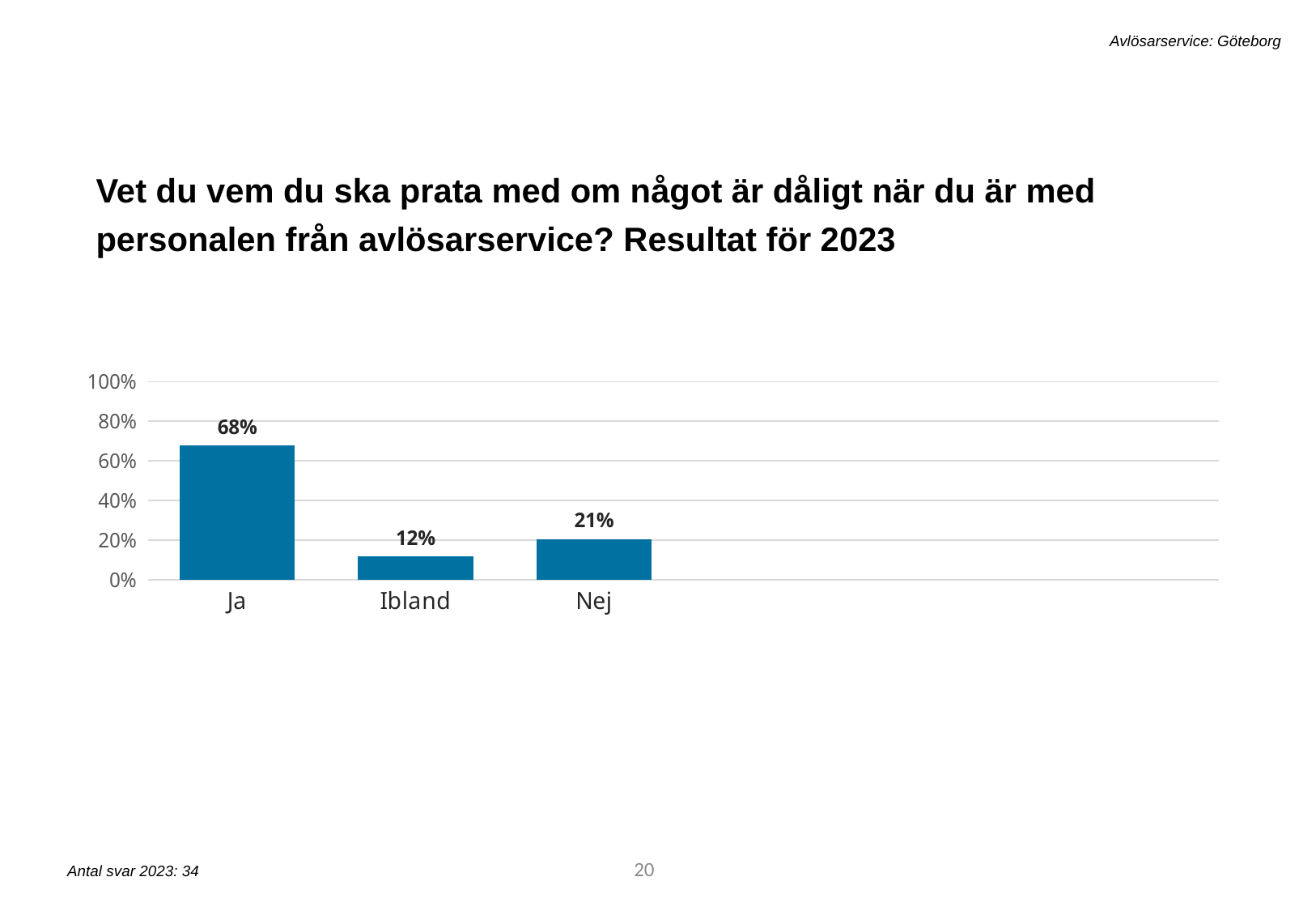
Which category has the highest value? Ja What kind of chart is shown on the slide? bar chart What is the value for Ibland? 12% Which is larger, the value for Nej or the value for Ibland? Nej What is the value for Nej? 21% What is the difference between the values for Nej and Ibland? 9% Which category has the lowest value? Ibland What is the difference between the values for Ja and Nej? 47% How many categories are shown on the x axis? 3 What is the value for Ja? 68% What is the number of responses (Antal svar) for 2023 stated on the slide? 34 Is the value for Ja greater or less than 60%? greater